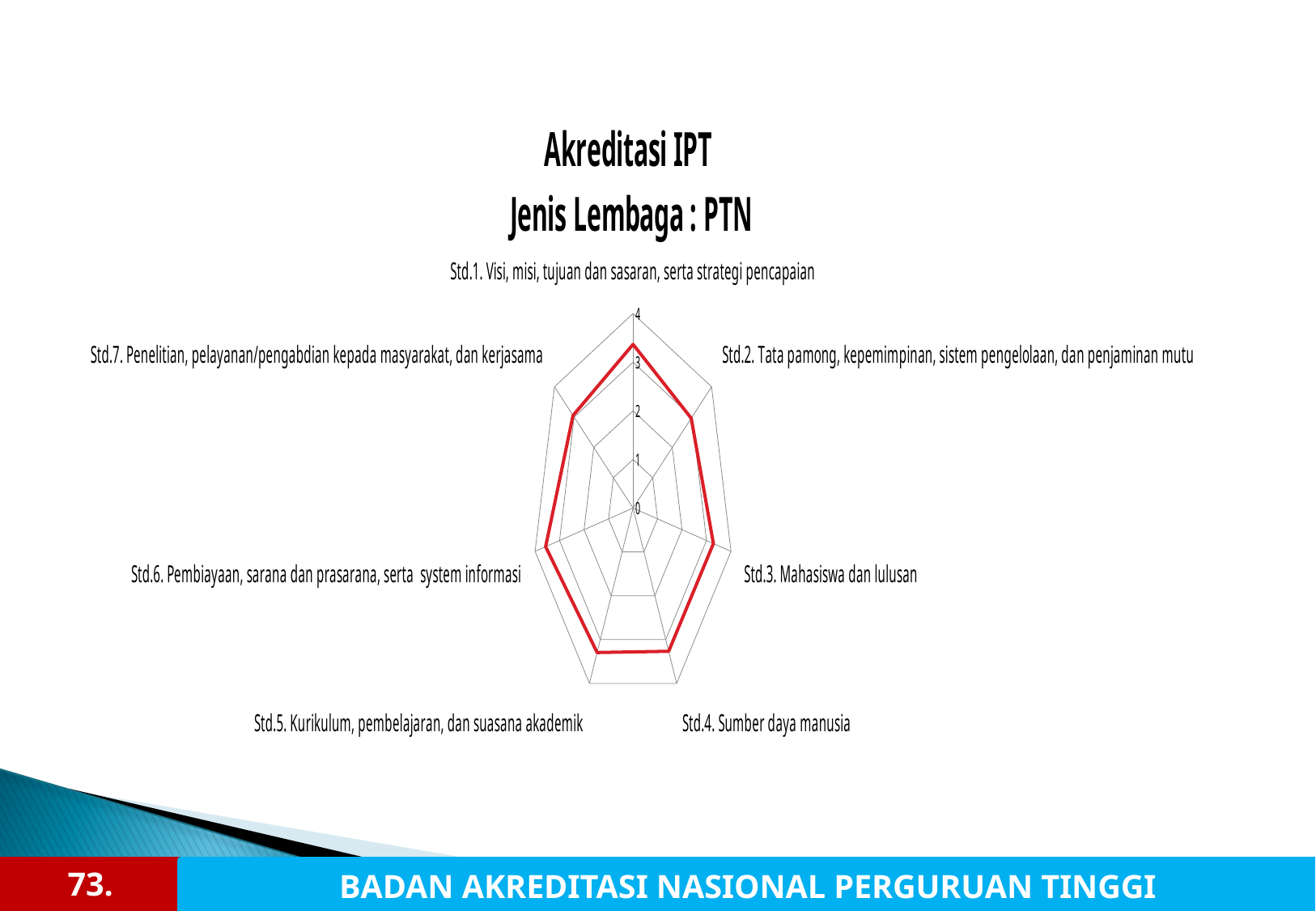
Is the value for Std.4. Sumber daya manusia greater or less than 1? greater Is the value for Std.7. Penelitian, pelayanan/pengabdian kepada masyarakat, dan kerjasama greater or less than 4? less Is the value for Std.1. Visi, misi, tujuan dan sasaran, serta strategi pencapaian greater or less than 2? greater What kind of chart is shown on the slide? radar chart What is the maximum value shown on the chart's axis scale? 4 What is the title of the chart? Akreditasi IPT Jenis Lembaga : PTN How many standards (categories) are plotted on the radar chart? 7